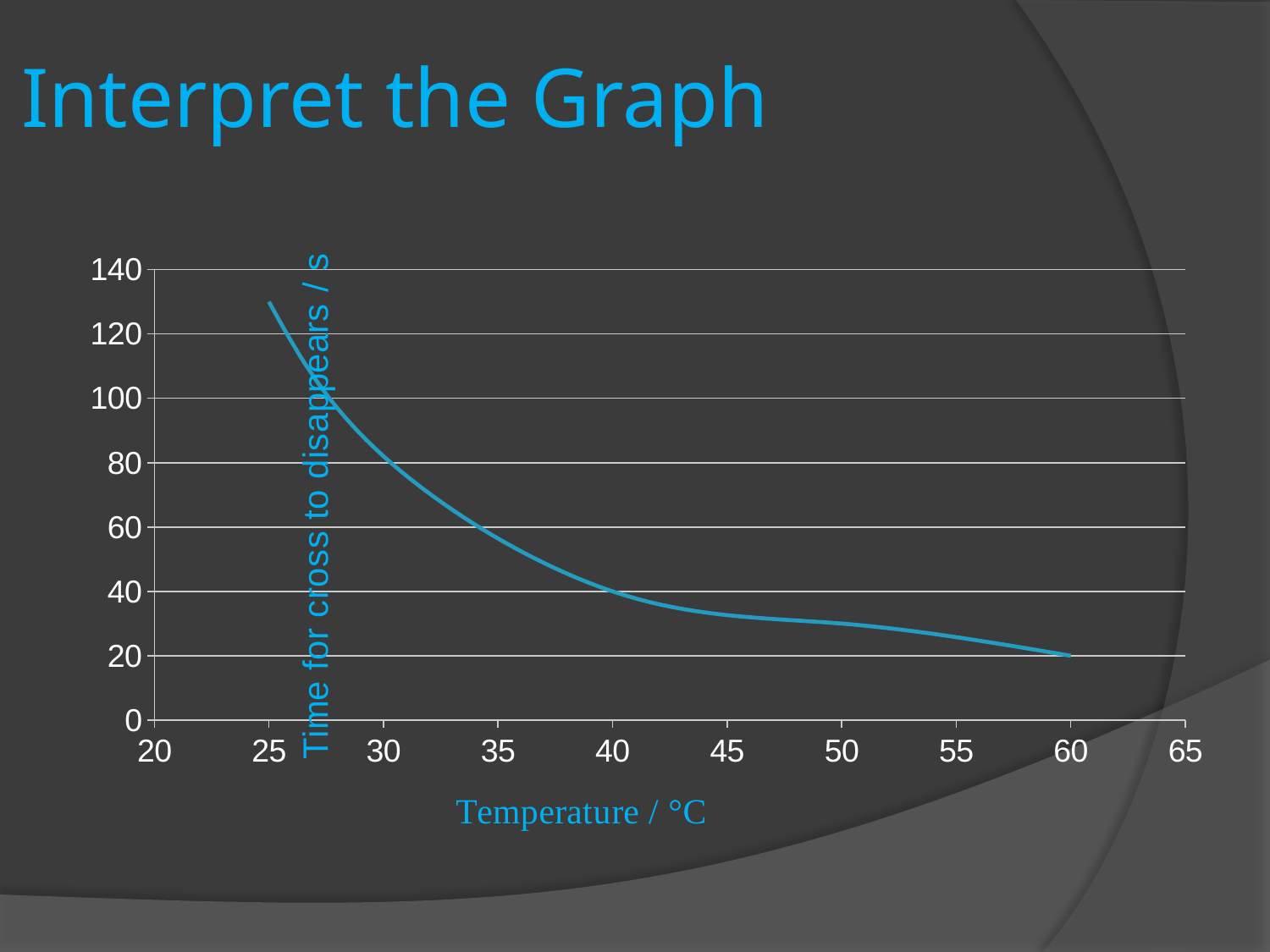
Is the time for the cross to disappear at 50 °C greater or less than 20? greater Is the time for the cross to disappear at 35 °C greater or less than 80? less As temperature increases along the x axis, does the time for the cross to disappear rise or fall? fall Is the time for the cross to disappear at 25 °C greater or less than 120? greater What is the title of the slide? Interpret the Graph What is the label of the x axis? Temperature / °C What is the time for the cross to disappear at 60 °C? 20 At which temperature shown is the time for the cross to disappear highest? 25 °C What kind of chart is shown on the slide? line chart At which temperature shown is the time for the cross to disappear lowest? 60 °C Which has the larger time for the cross to disappear, 30 °C or 50 °C? 30 °C